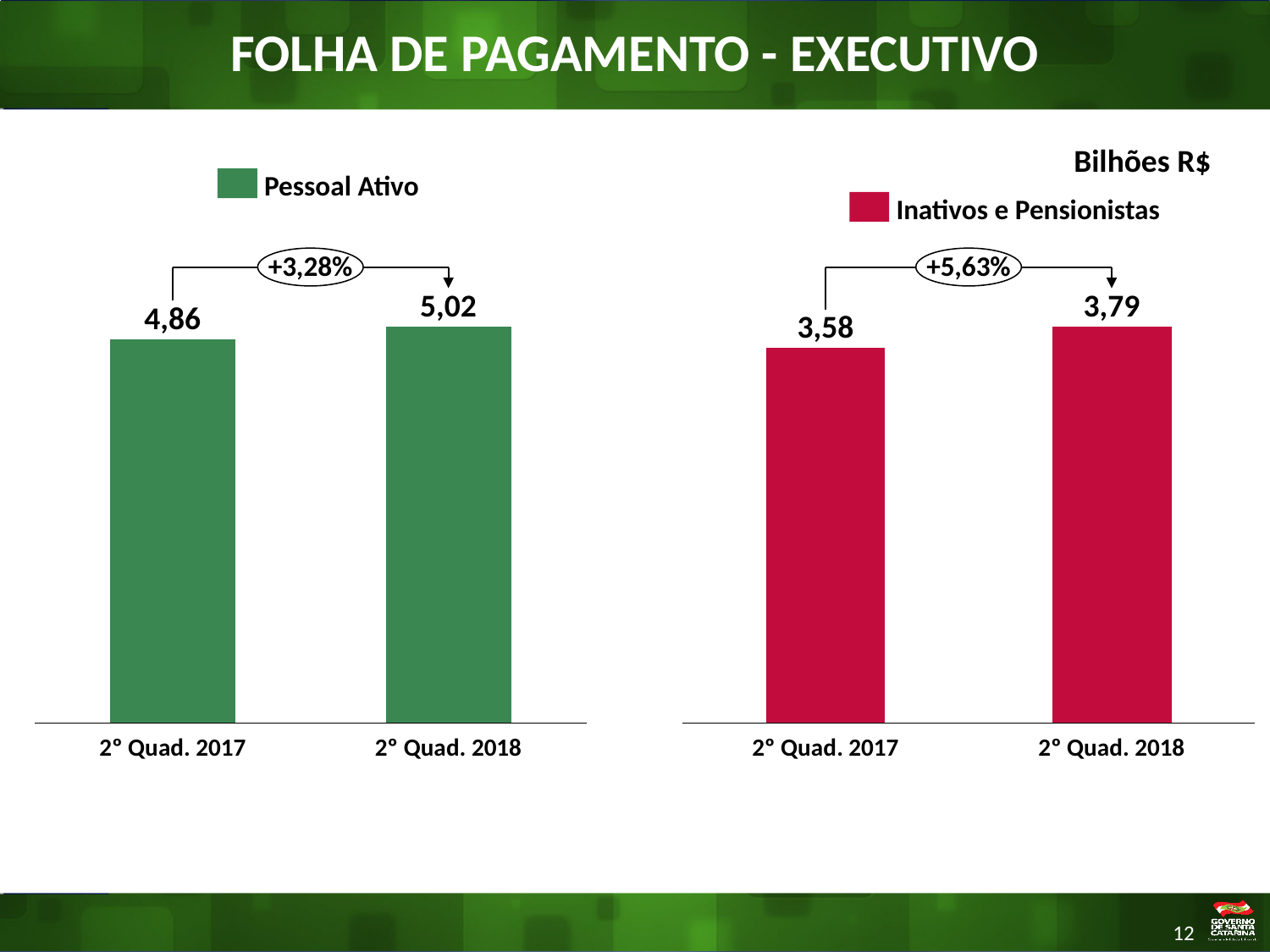
In the Pessoal Ativo chart, what percentage change is shown between 2° Quad. 2017 and 2° Quad. 2018? +3,28% In the Pessoal Ativo chart, what is the value for 2° Quad. 2018? 5,02 In the Pessoal Ativo chart, what is the difference between the 2° Quad. 2018 and 2° Quad. 2017 values? 0,16 What kind of chart is the Pessoal Ativo chart? bar chart In the Inativos e Pensionistas chart, what percentage change is shown between 2° Quad. 2017 and 2° Quad. 2018? +5,63% In the Inativos e Pensionistas chart, which period has the higher value? 2° Quad. 2018 What unit is indicated for the values on the slide? Bilhões R$ In the Inativos e Pensionistas chart, what is the value for 2° Quad. 2018? 3,79 In the Inativos e Pensionistas chart, what is the difference between the 2° Quad. 2018 and 2° Quad. 2017 values? 0,21 In the Pessoal Ativo chart, do the values rise or fall from 2° Quad. 2017 to 2° Quad. 2018? rise In the Pessoal Ativo chart, what is the value for 2° Quad. 2017? 4,86 In the Inativos e Pensionistas chart, what is the value for 2° Quad. 2017? 3,58